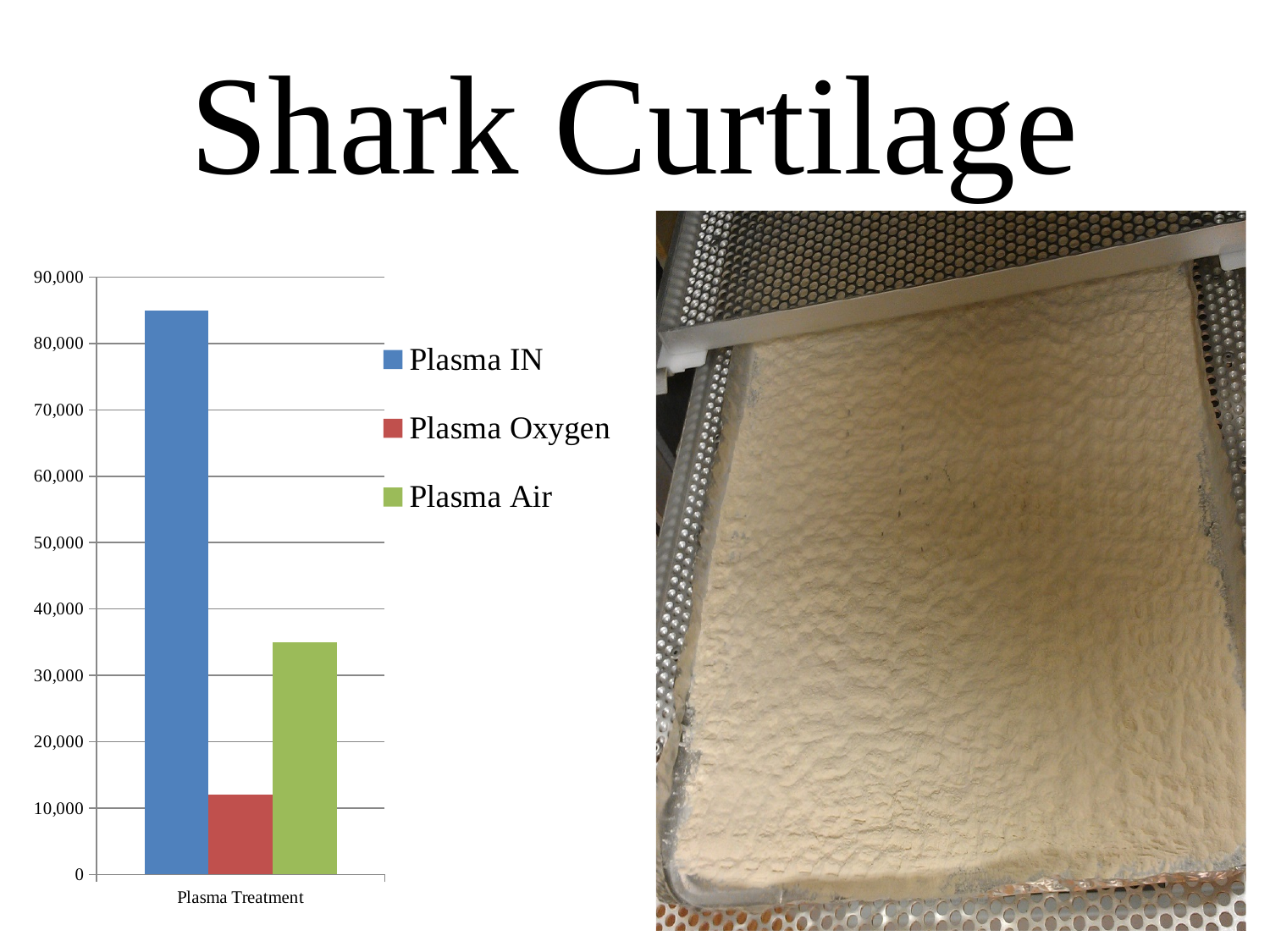
What colour is the bar for Plasma Oxygen? red Which series has the highest value in the chart? Plasma IN Is the value for Plasma Air greater or less than 40,000? less What kind of chart is shown on the slide? bar chart Which is larger, the value for Plasma IN or the value for Plasma Air? Plasma IN Is the value for Plasma IN greater or less than 80,000? greater Is the value for Plasma Air greater or less than 30,000? greater Which series has the lowest value in the chart? Plasma Oxygen Which is larger, the value for Plasma Air or the value for Plasma Oxygen? Plasma Air What is the label shown on the x axis of the chart? Plasma Treatment How many series does the chart's legend list? 3